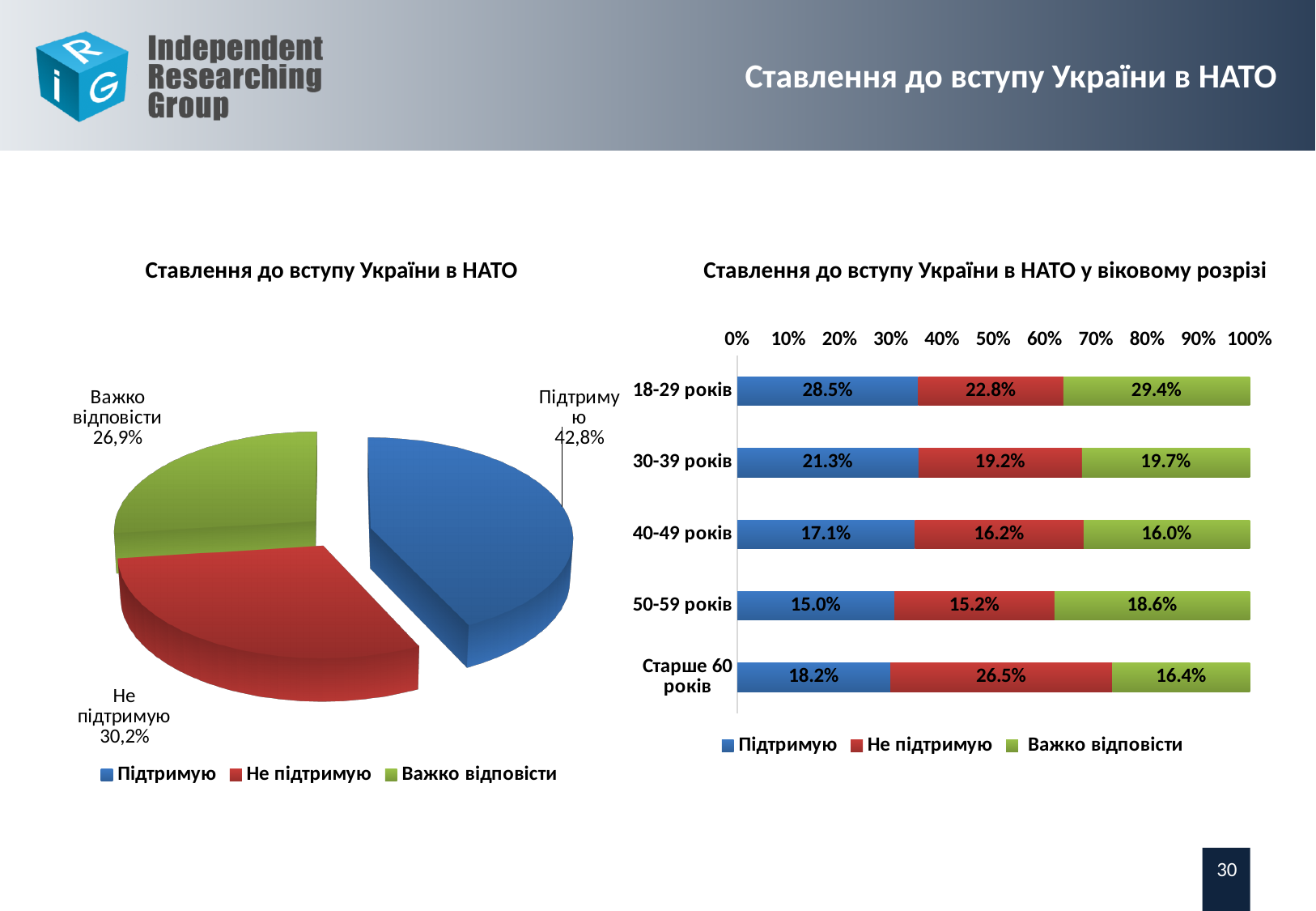
What kind of chart is the chart on the left of the slide? Pie chart What kind of chart is 'Ставлення до вступу України в НАТО у віковому розрізі'? Bar chart In the pie chart 'Ставлення до вступу України в НАТО', which slice is the largest? Підтримую In the chart 'Ставлення до вступу України в НАТО у віковому розрізі', what is the 'Підтримую' value for '18-29 років'? 28.5% In the chart 'Ставлення до вступу України в НАТО у віковому розрізі', how many series does the legend list? 3 In the pie chart 'Ставлення до вступу України в НАТО', what is the value for 'Не підтримую'? 30,2% In the chart 'Ставлення до вступу України в НАТО у віковому розрізі', how many age groups are shown? 5 In the chart 'Ставлення до вступу України в НАТО у віковому розрізі', which age group has the highest 'Підтримую' value? 18-29 років In the pie chart 'Ставлення до вступу України в НАТО', what is the value for 'Підтримую'? 42,8% In the chart 'Ставлення до вступу України в НАТО у віковому розрізі', what is the 'Не підтримую' value for 'Старше 60 років'? 26.5% In the chart 'Ставлення до вступу України в НАТО у віковому розрізі', what is the difference between the 'Важко відповісти' values for '18-29 років' and '40-49 років'? 13.4% In the pie chart 'Ставлення до вступу України в НАТО', which slice is the smallest? Важко відповісти